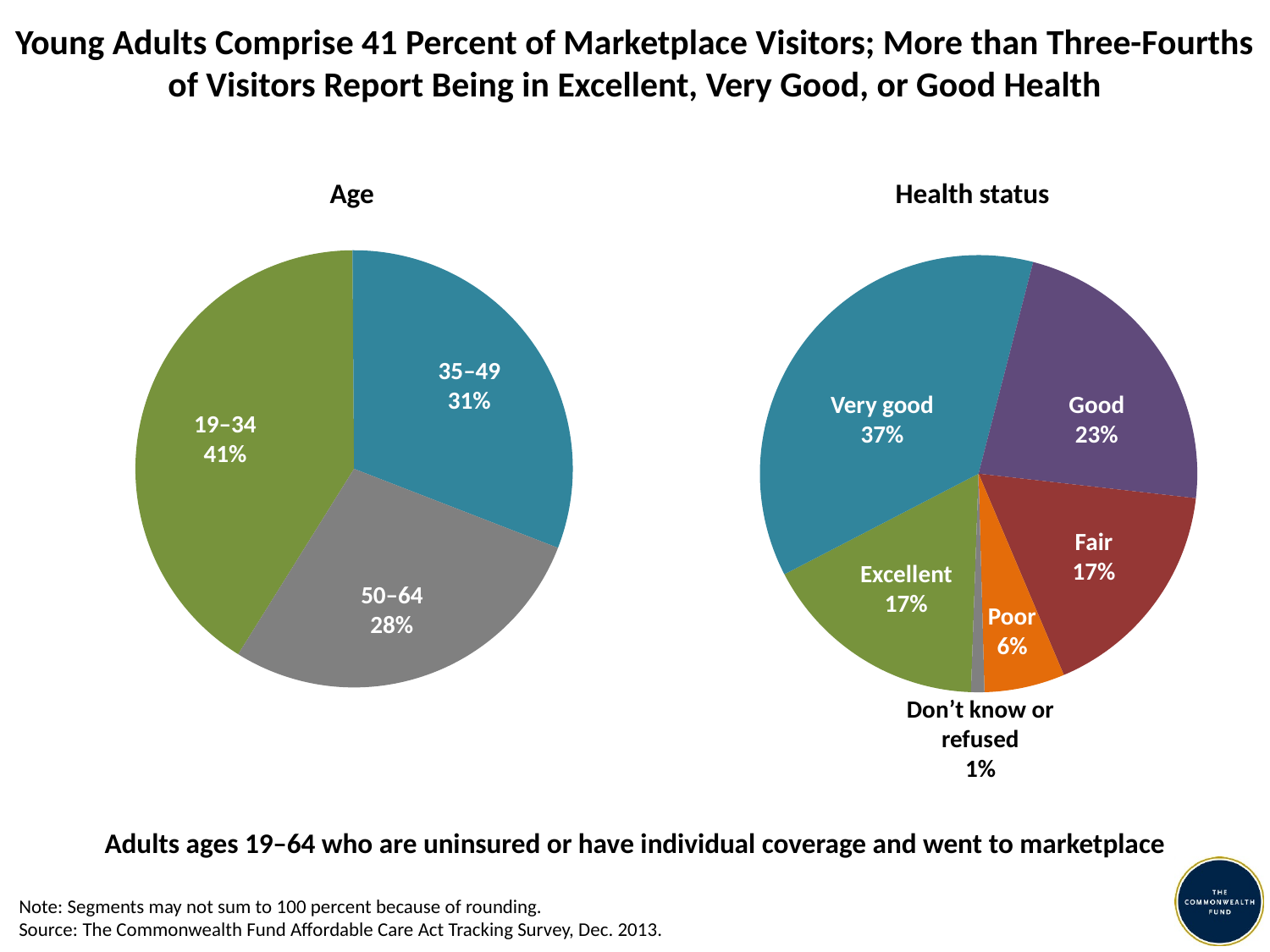
How many categories are shown in the Health status pie chart? 6 In the Age pie chart, what percentage of marketplace visitors are ages 19–34? 41% In the Age pie chart, which age group has the smallest share? 50–64 In the Health status pie chart, which health status category has the largest share? Very good In the Health status pie chart, which category has the smallest share? Don't know or refused In the Age pie chart, what share of visitors are ages 50–64? 28% In the Health status pie chart, what percentage of visitors report poor health? 6% In the Health status pie chart, what percentage of visitors report being in very good health? 37% In the Health status pie chart, which is larger: the share reporting Good health or the share reporting Excellent health? Good In the Age pie chart, what is the difference in percentage points between the 19–34 and 35–49 groups? 10 In the Age pie chart, which age group has the largest share? 19–34 What type of chart is used to show the Age distribution? Pie chart